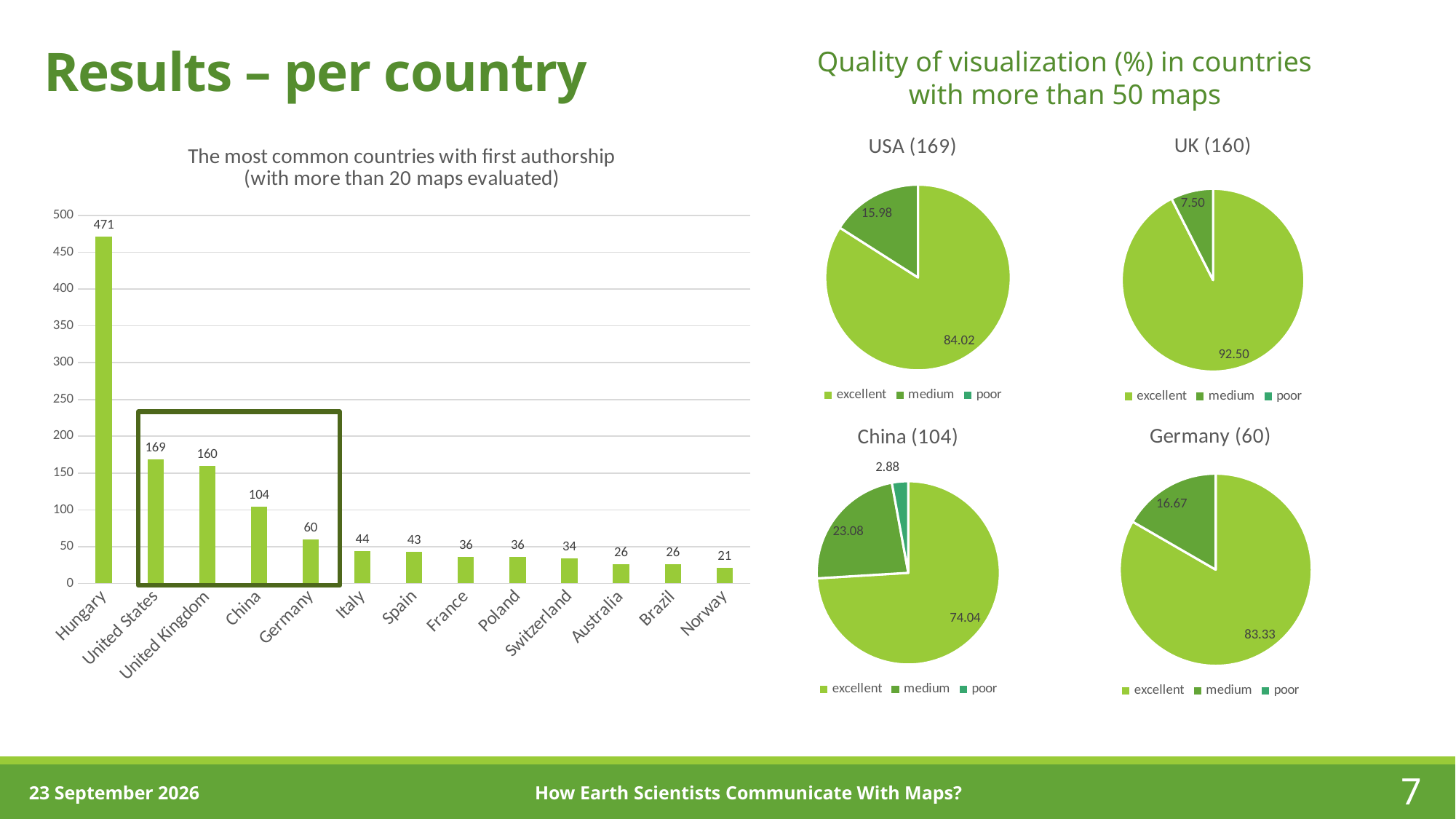
In the bar chart 'The most common countries with first authorship', do the values rise or fall from left to right along the x axis? fall In the pie chart 'USA (169)', what is the value for excellent? 84.02 What kind of chart is 'The most common countries with first authorship'? bar chart In the bar chart 'The most common countries with first authorship', what is the value for Hungary? 471 In the pie chart 'China (104)', what is the value for poor? 2.88 In the bar chart 'The most common countries with first authorship', which has a larger value, China or Germany? China In the bar chart 'The most common countries with first authorship', what is the difference between the values for United States and United Kingdom? 9 In the bar chart 'The most common countries with first authorship', which country has the highest value? Hungary In the bar chart 'The most common countries with first authorship', which country has the lowest value? Norway How many entries does the legend of the pie chart 'Germany (60)' list? 3 In the pie chart 'UK (160)', what is the value for medium? 7.50 How many countries are shown in the bar chart 'The most common countries with first authorship'? 13